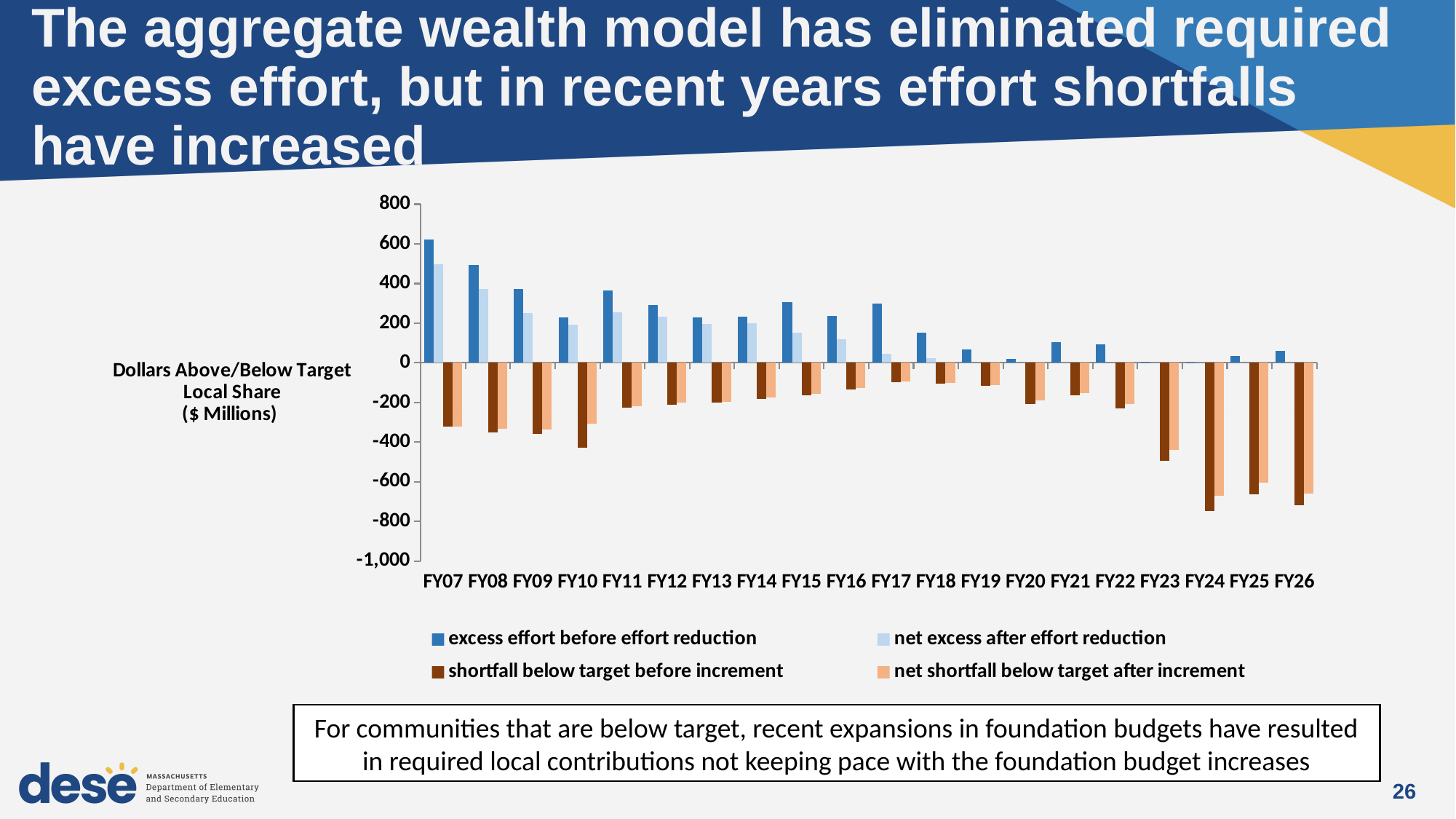
What is the label on the vertical axis of the chart? Dollars Above/Below Target Local Share ($ Millions) Which fiscal year has the highest value for 'excess effort before effort reduction'? FY07 What kind of chart is shown on the slide? bar chart Is the value for 'shortfall below target before increment' in FY24 greater or less than -600? less Is the value for 'net excess after effort reduction' in FY08 greater or less than 200? greater How many series does the chart's legend list? 4 Is the value for 'excess effort before effort reduction' in FY07 greater or less than 400? greater Which fiscal year has a larger shortfall below target before increment, FY07 or FY24? FY24 Does the 'excess effort before effort reduction' series generally rise or fall from FY07 to FY26? fall Which is larger, the 'excess effort before effort reduction' value in FY07 or in FY08? FY07 How many fiscal years are shown on the x axis of the chart? 20